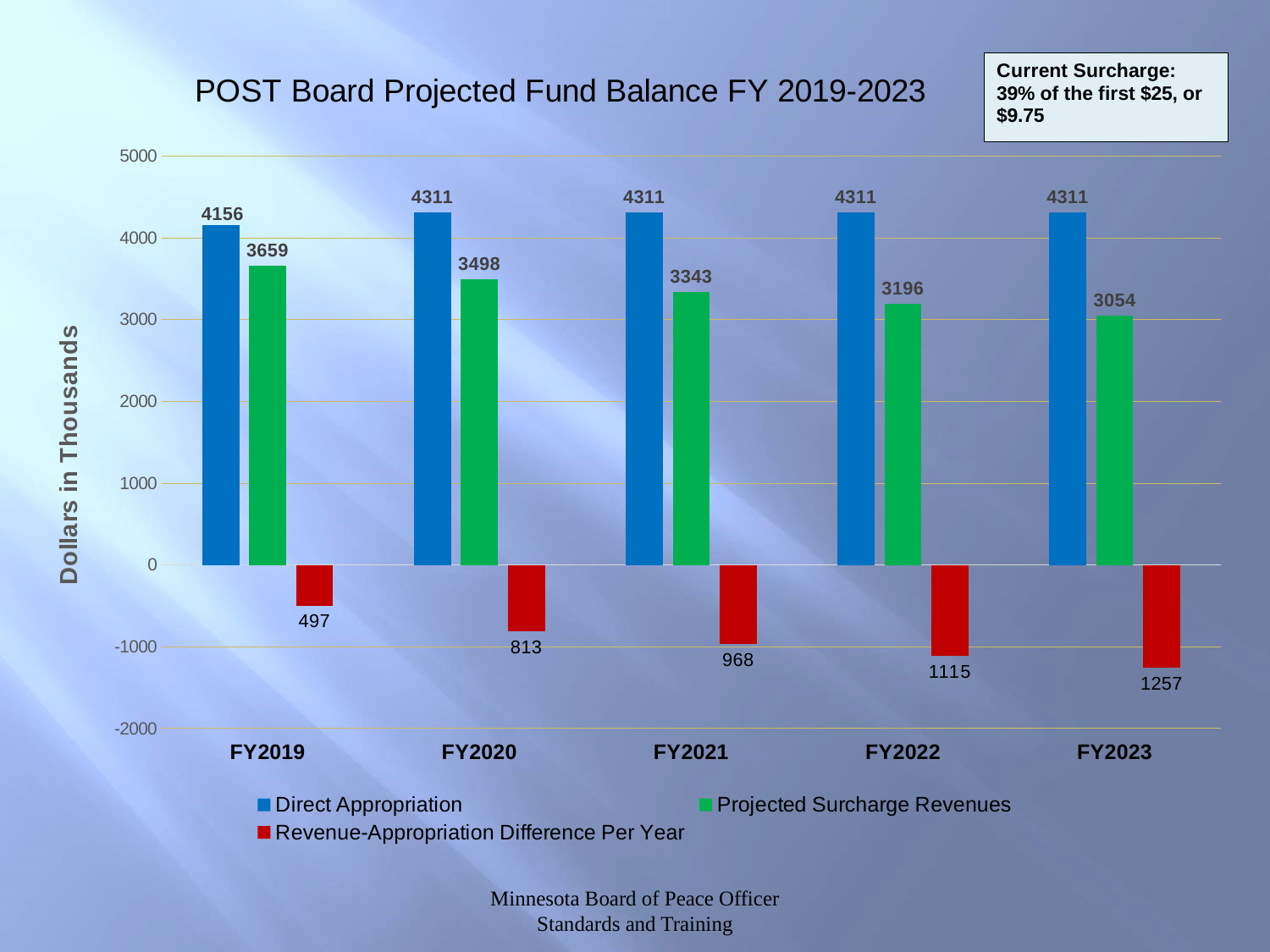
Which is larger in FY2022, Direct Appropriation or Projected Surcharge Revenues? Direct Appropriation What kind of chart is shown on the slide? bar chart What is the difference between Direct Appropriation and Projected Surcharge Revenues in FY2020? 813 Is the Projected Surcharge Revenues value for FY2023 greater or less than 4000? less What is the Projected Surcharge Revenues value for FY2021? 3343 How many series does the legend list? 3 Do the Projected Surcharge Revenues values rise or fall from FY2019 to FY2023? fall Which fiscal year has the highest Projected Surcharge Revenues? FY2019 What is the data label on the Revenue-Appropriation Difference Per Year bar for FY2023? 1257 What is the Direct Appropriation value for FY2019? 4156 How many fiscal years are shown on the x axis? 5 Which fiscal year has the lowest Projected Surcharge Revenues? FY2023